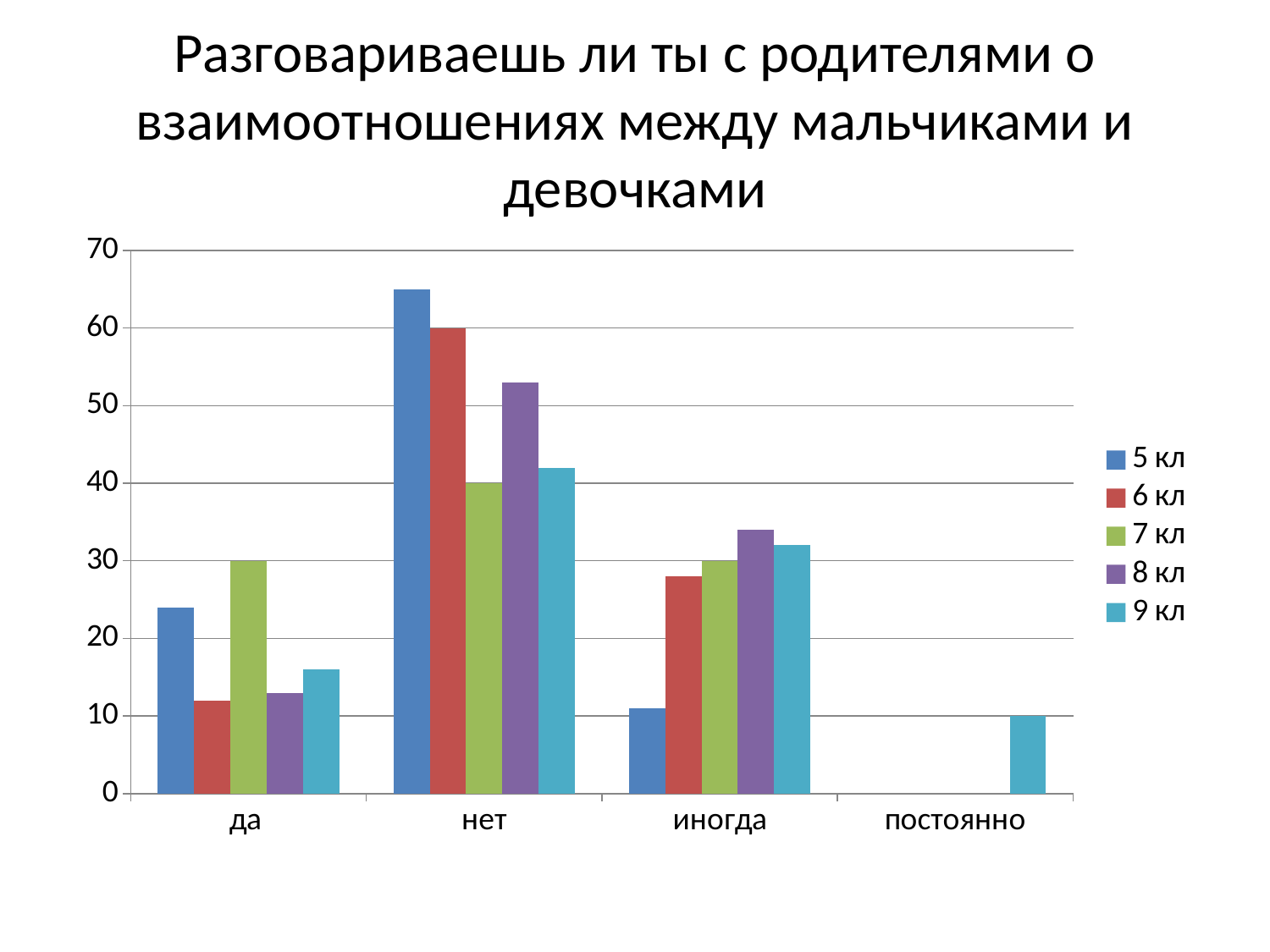
What kind of chart is shown on the slide? bar chart Which series is the only one with a bar in the category постоянно? 9 кл Which series has the highest value in the category нет? 5 кл What is the value for 6 кл in the category нет? 60 What is the value for 7 кл in the category нет? 40 Is the value for 8 кл in the category да greater or less than 20? less How many categories are shown on the x axis? 4 Is the value for 5 кл in the category нет greater or less than 60? greater How many series does the legend list? 5 What is the value for 9 кл in the category постоянно? 10 Which series has the lowest value in the category иногда? 5 кл Which is larger in the category да: the value for 5 кл or the value for 6 кл? 5 кл